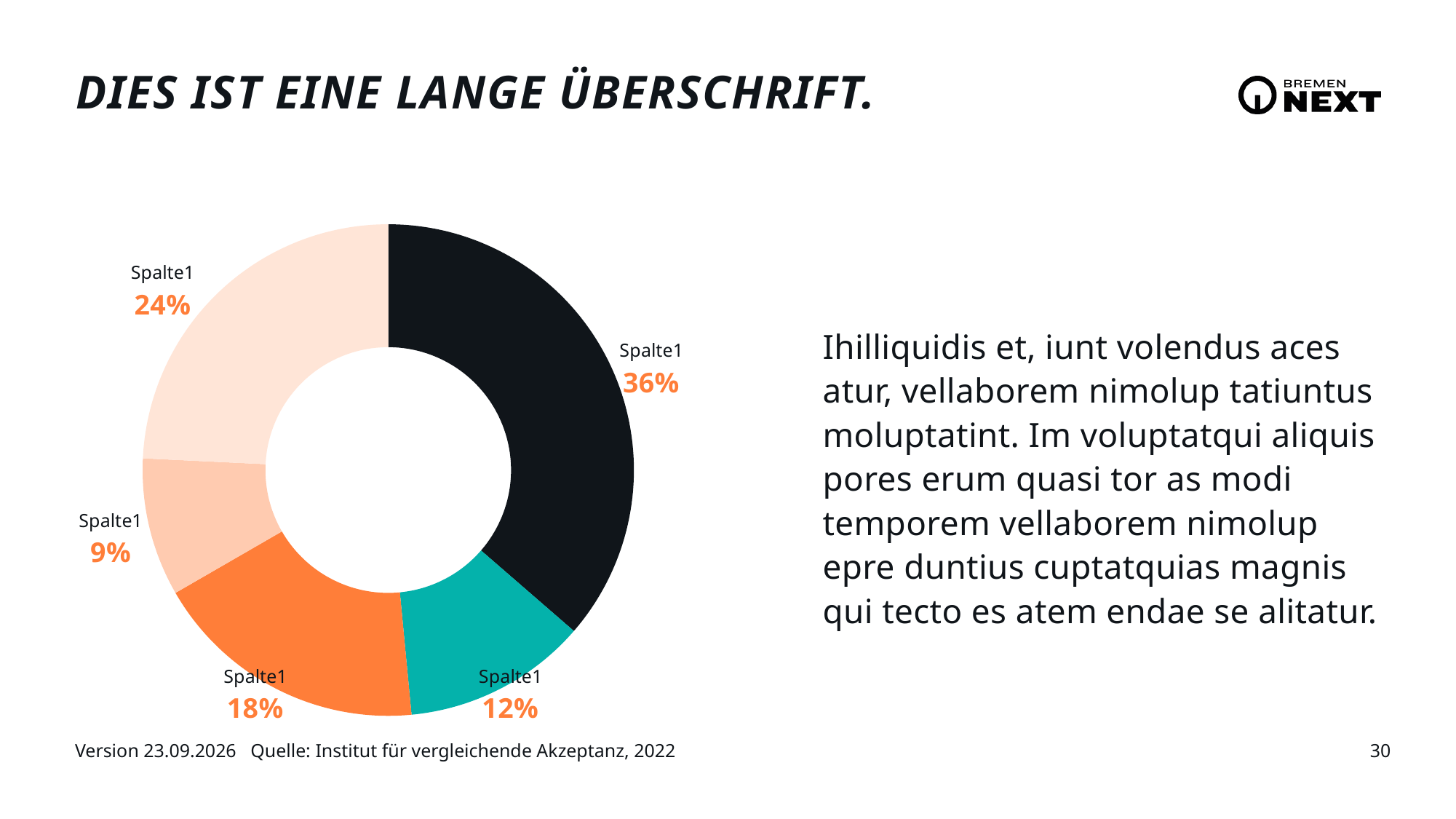
What is the smallest percentage shown on the pie chart? 9% What percentage is shown for the orange slice of the pie chart? 18% What percentage is shown for the black slice of the pie chart? 36% What is the largest percentage shown on the pie chart? 36% What kind of chart is shown on the slide? pie chart (donut) What label is used for every slice of the pie chart? Spalte1 How many slices does the pie chart have? 5 What is the difference in percentage points between the black slice (36%) and the teal slice (12%)? 24 percentage points What percentage is shown for the teal slice of the pie chart? 12% What source is cited below the chart? Institut für vergleichende Akzeptanz, 2022 Which slice is larger, the orange slice or the teal slice? the orange slice (18%) What is the difference in percentage points between the 24% slice and the 9% slice? 15 percentage points